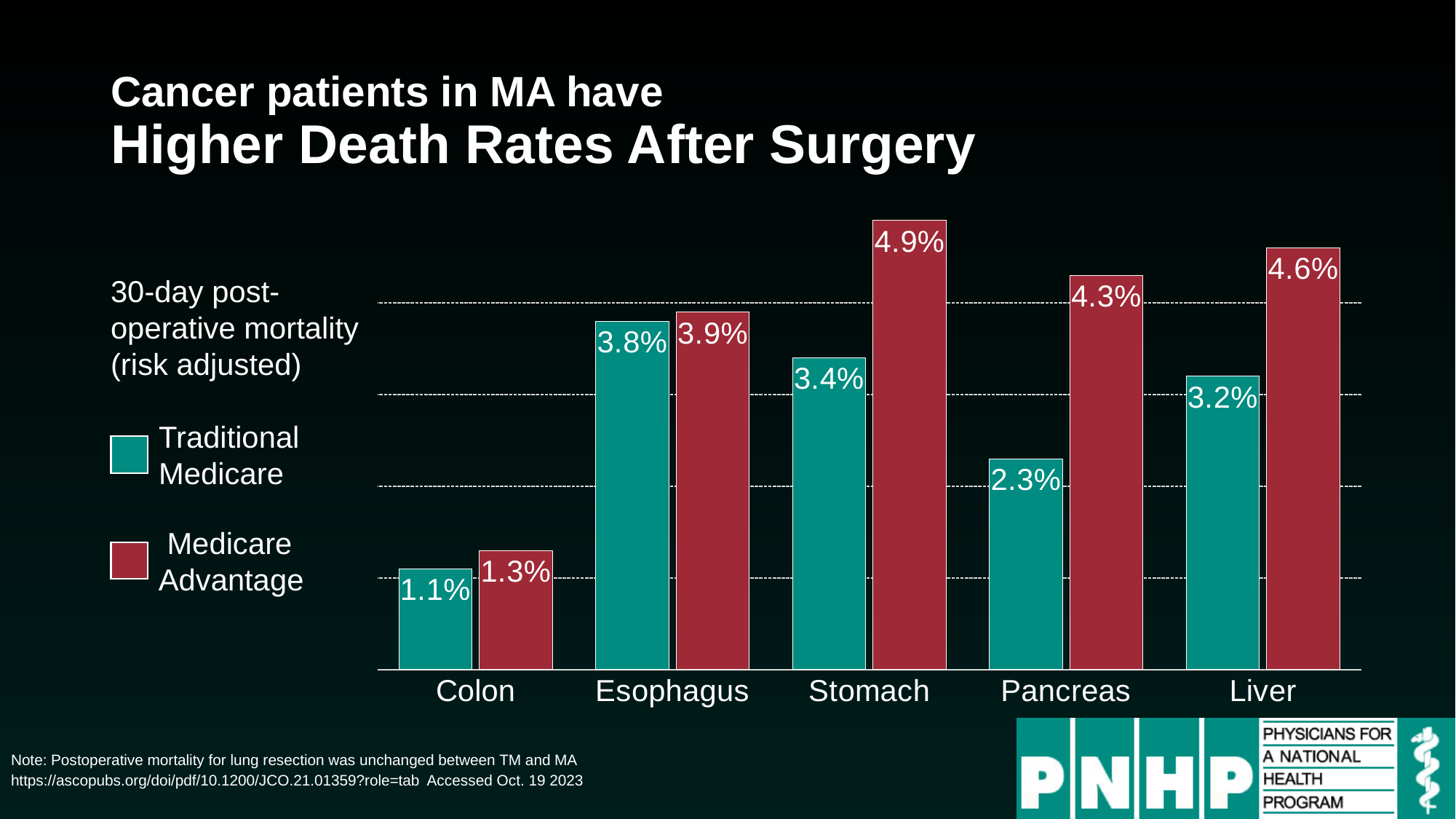
Which cancer type has the lowest Traditional Medicare mortality rate? Colon What is the 30-day post-operative mortality for Traditional Medicare patients with stomach cancer? 3.4% Which colour represents Traditional Medicare in the chart? Teal (green) How many cancer types are shown on the x axis? 5 Which is larger for liver cancer: the Traditional Medicare rate or the Medicare Advantage rate? Medicare Advantage What is the Medicare Advantage mortality value for colon cancer? 1.3% Which cancer type has the highest Medicare Advantage mortality rate? Stomach What is the difference between the Medicare Advantage and Traditional Medicare mortality rates for stomach cancer? 1.5% How many series does the legend list? 2 What kind of chart is shown on the slide? Bar chart What is the 30-day post-operative mortality for Medicare Advantage patients with pancreas cancer? 4.3% What is the difference between the Medicare Advantage and Traditional Medicare mortality rates for pancreas cancer? 2.0%